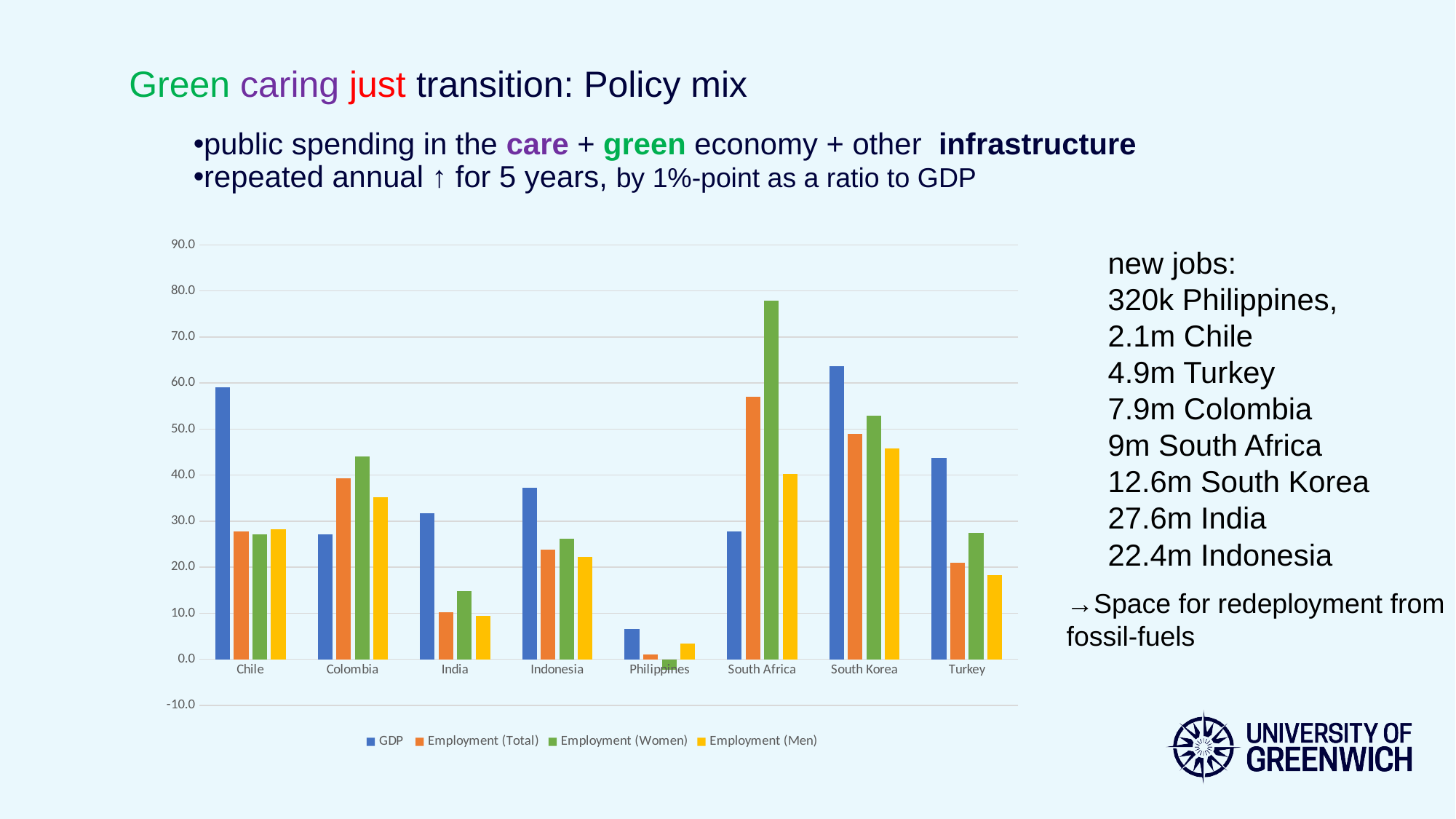
Which is larger: the Employment (Women) value for Colombia or for Chile? Colombia Which country has the highest Employment (Women) value in the chart? South Africa Which country has the lowest GDP value in the chart? Philippines How many series does the chart's legend list? 4 What kind of chart is shown on the slide? bar chart Is the Employment (Total) value for India greater or less than 20? less Which series is shown in green in the chart's legend? Employment (Women) Is the GDP value for Chile greater or less than 50? greater Is the Employment (Women) value for South Africa greater or less than 70? greater Which is larger: the GDP value for South Korea or for Turkey? South Korea How many countries are shown on the x axis of the chart? 8 Which country has the highest GDP value in the chart? South Korea